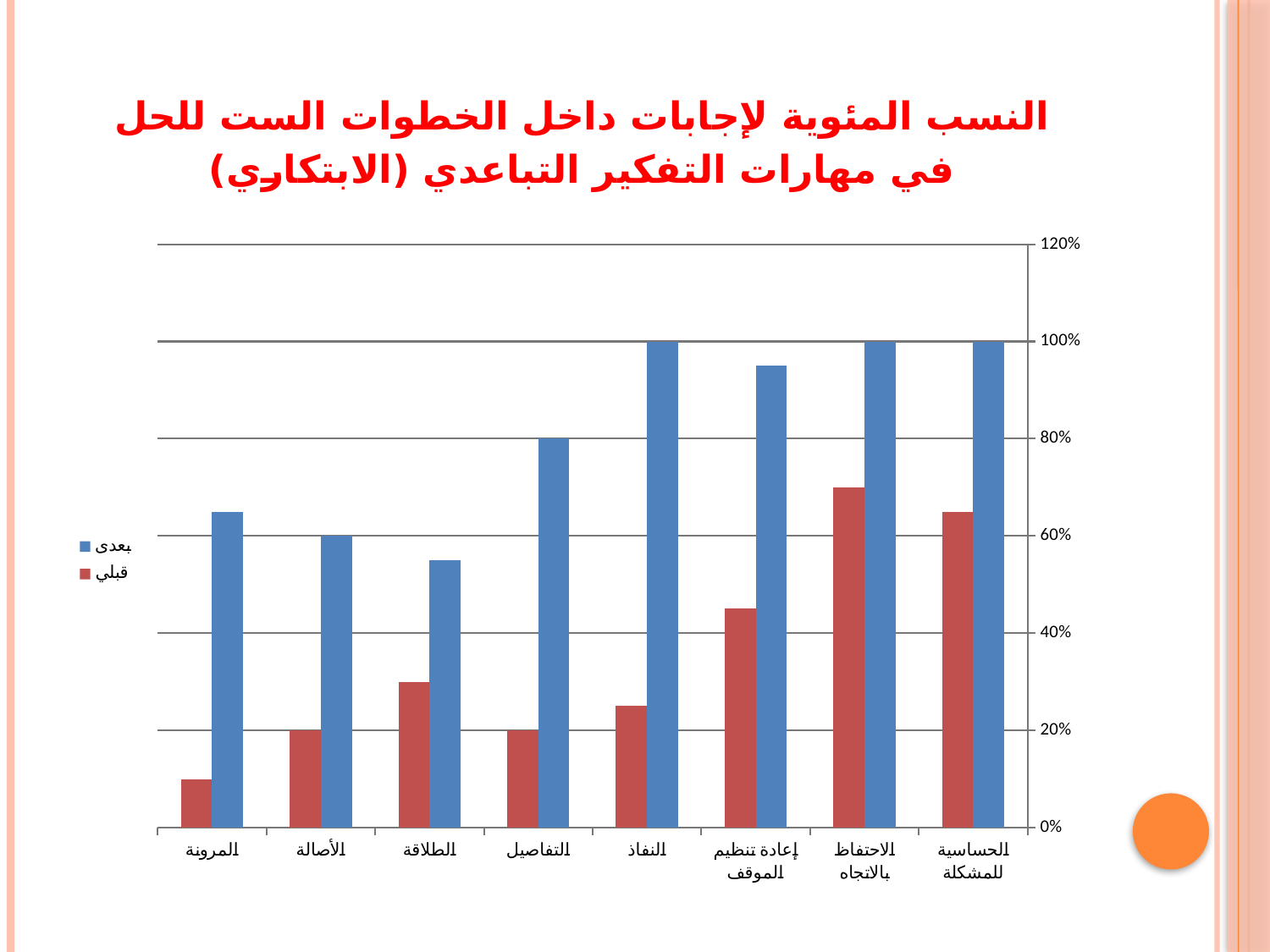
For الطلاقة, which series has the larger value, بعدى or قبلي? بعدى What is the value of the بعدى series for التفاصيل? 80% Is the قبلي value for المرونة greater or less than 20%? less How many categories are shown on the x axis? 8 What is the difference between the بعدى and قبلي values for التفاصيل? 60% How many series does the legend list? 2 Which category has the lowest value in the قبلي series? المرونة What is the value of the بعدى series for النفاذ? 100% What is the value of the بعدى series for الأصالة? 60% Is the بعدى value for إعادة تنظيم الموقف greater or less than 100%? less What is the value of the قبلي series for الأصالة? 20% What kind of chart is shown on the slide? bar chart